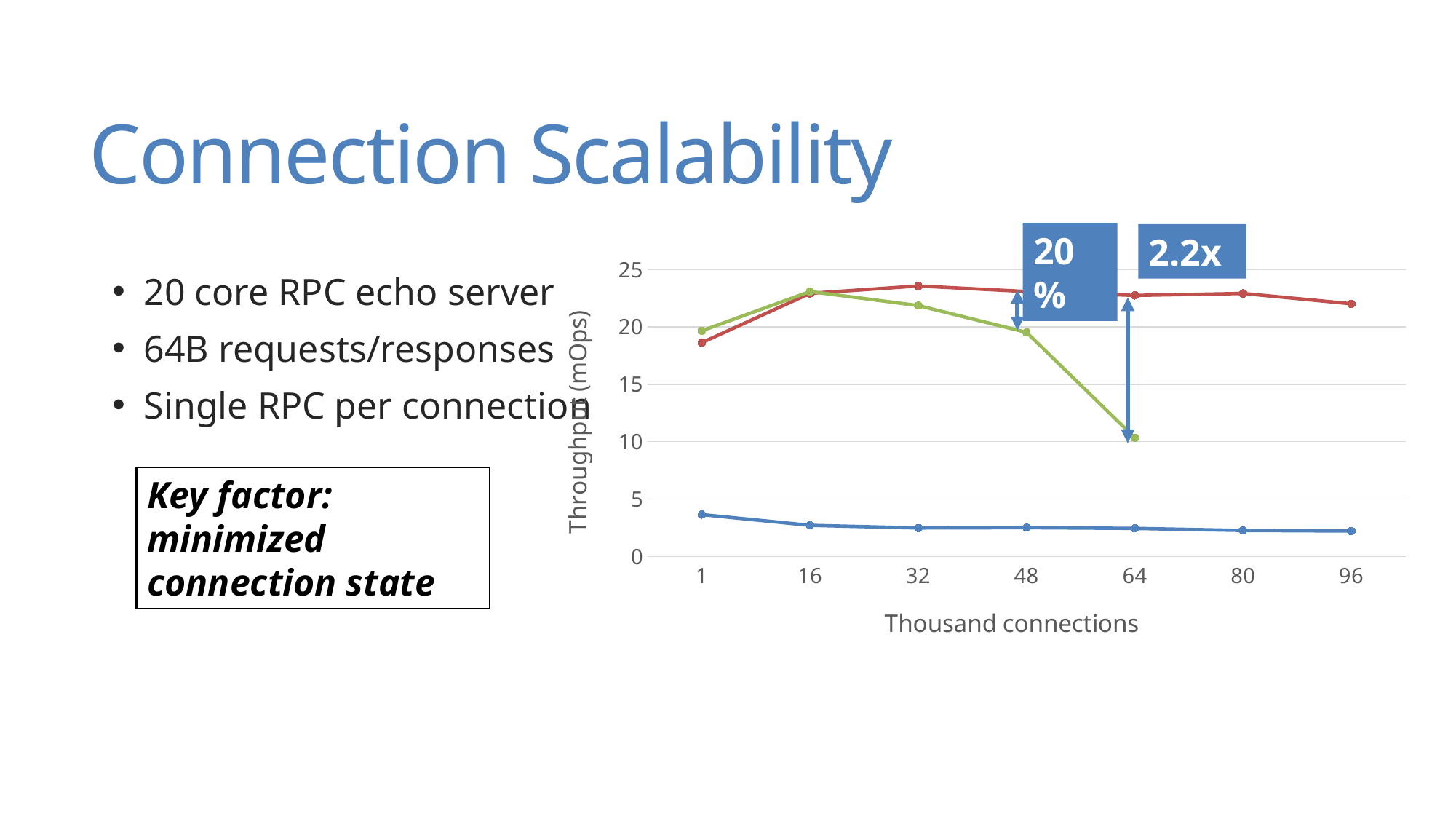
Is the value of the green line at 64 thousand connections greater or less than 15? less At 64 thousand connections, which line has the higher value, the red line or the green line? red line Does the green line rise or fall between 32 and 64 thousand connections? fall What is the title of the y axis of the chart? Throughput (mOps) Which line has the lowest values across all connection counts? blue line What kind of chart is shown on the slide? line chart Is the value of the green line at 16 thousand connections greater or less than 20? greater At 48 thousand connections, which line has the lower value, the blue line or the green line? blue line Is the value of the blue line at 1 thousand connections greater or less than 5? less What is the title of the x axis of the chart? Thousand connections How many values are labelled on the x axis of the chart? 7